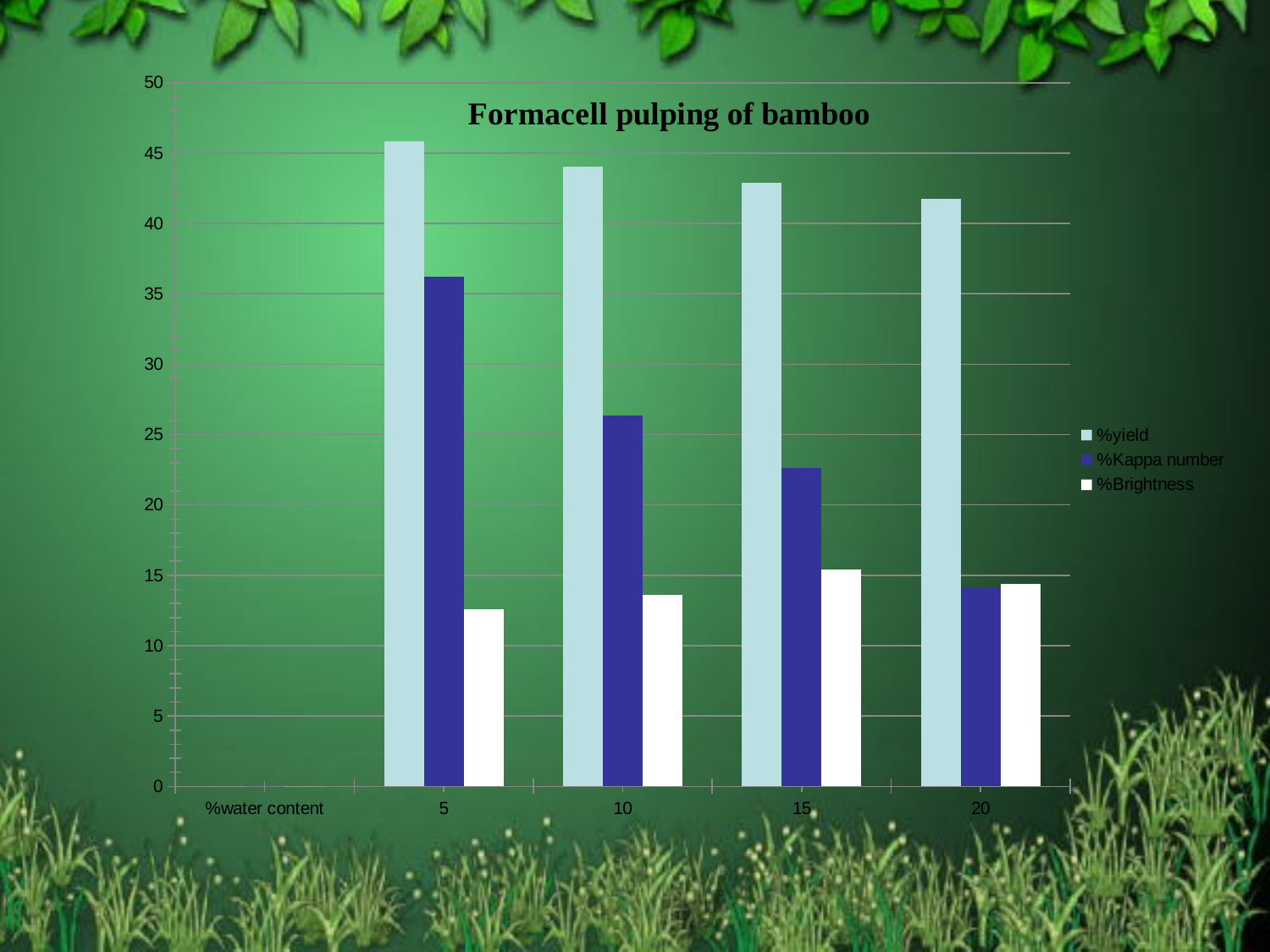
What is the title of the chart? Formacell pulping of bamboo Which series is shown in dark blue in the legend? %Kappa number What kind of chart is shown on the slide? bar chart Is the %yield value at 5% water content greater or less than 40? greater Is the %Kappa number value at 20% water content greater or less than 20? less At which %water content is %yield highest? 5 At 5% water content, which is larger: %Kappa number or %Brightness? %Kappa number Does %Kappa number rise or fall as %water content increases from 5 to 20? fall How many series does the legend list? 3 Is the %Kappa number value at 5% water content greater or less than 35? greater At which %water content is %Kappa number lowest? 20